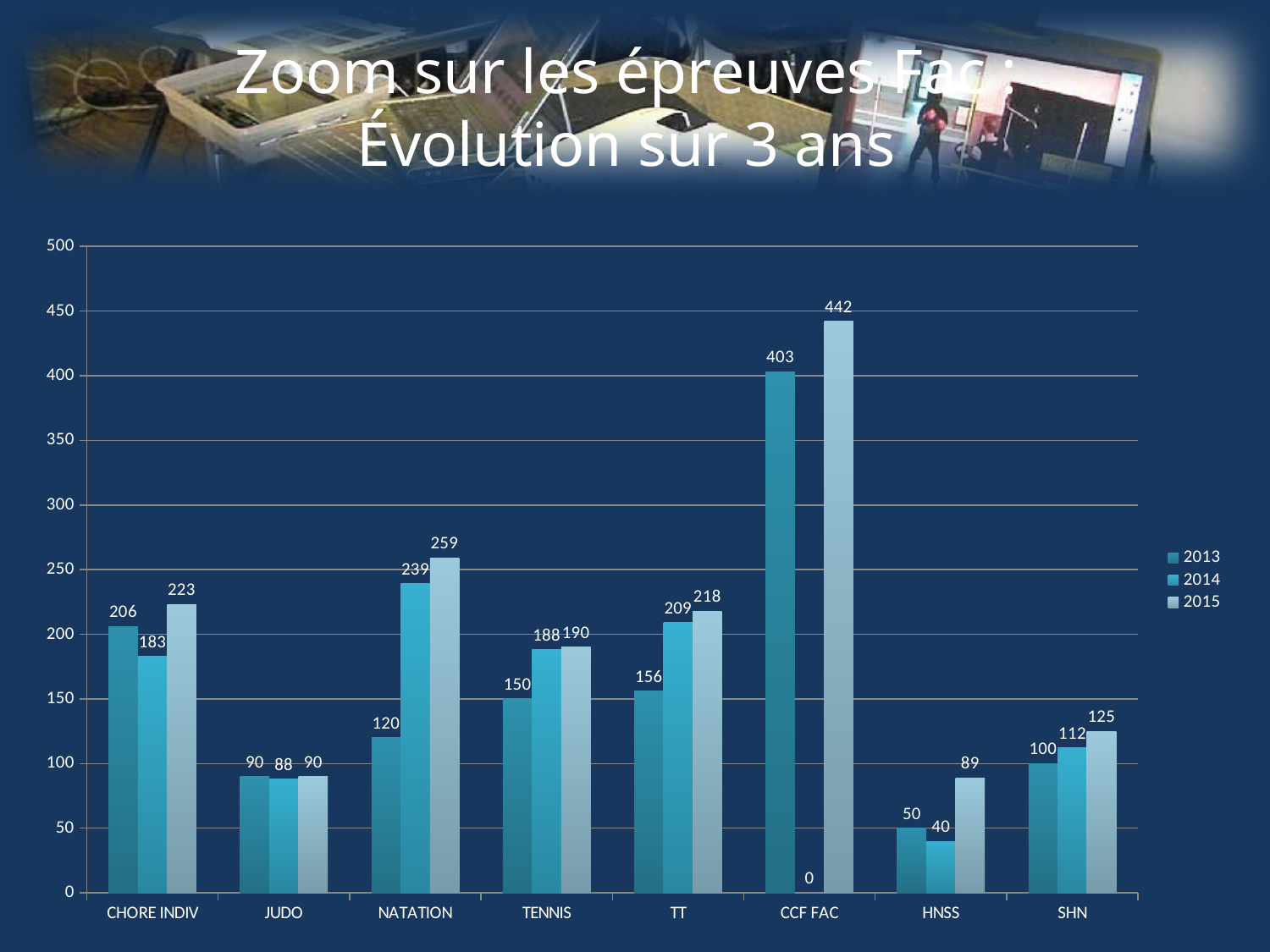
How many categories are shown on the x axis? 8 How many series does the legend list? 3 Which category has the lowest value in 2013? HNSS What kind of chart is shown on the slide? Bar chart Which category has the highest value in 2015? CCF FAC What is the value for HNSS in 2013? 50 Which is larger for TT: the 2014 value or the 2015 value? 2015 What is the difference between the 2015 and 2013 values for CCF FAC? 39 What is the value for NATATION in 2015? 259 Do the values for SHN rise or fall from 2013 to 2015? Rise What is the title of the slide? Zoom sur les épreuves Fac : Évolution sur 3 ans What is the value for CCF FAC in 2014? 0